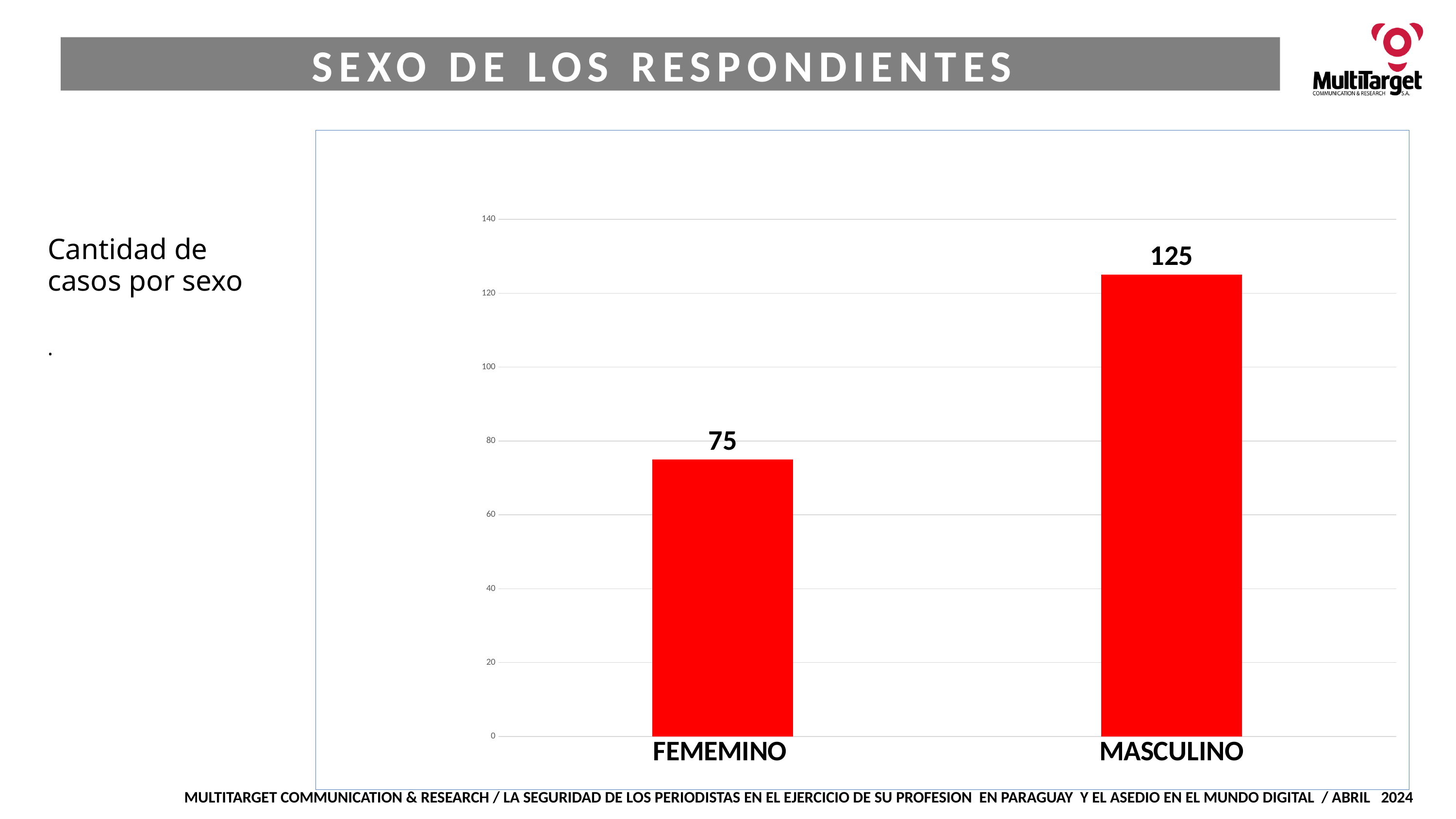
What kind of chart is shown on the slide? bar chart Which is larger, the value for FEMEMINO or the value for MASCULINO? MASCULINO What is the value for MASCULINO? 125 Which category has the lowest value? FEMEMINO What is the value for FEMEMINO? 75 Which category has the highest value? MASCULINO What colour are the bars in the chart? red What is the difference between the values for MASCULINO and FEMEMINO? 50 How many categories are shown in the chart? 2 Is the value for FEMEMINO greater or less than 80? less Is the value for MASCULINO greater or less than 100? greater What is the title shown in the grey banner at the top of the slide? SEXO DE LOS RESPONDIENTES